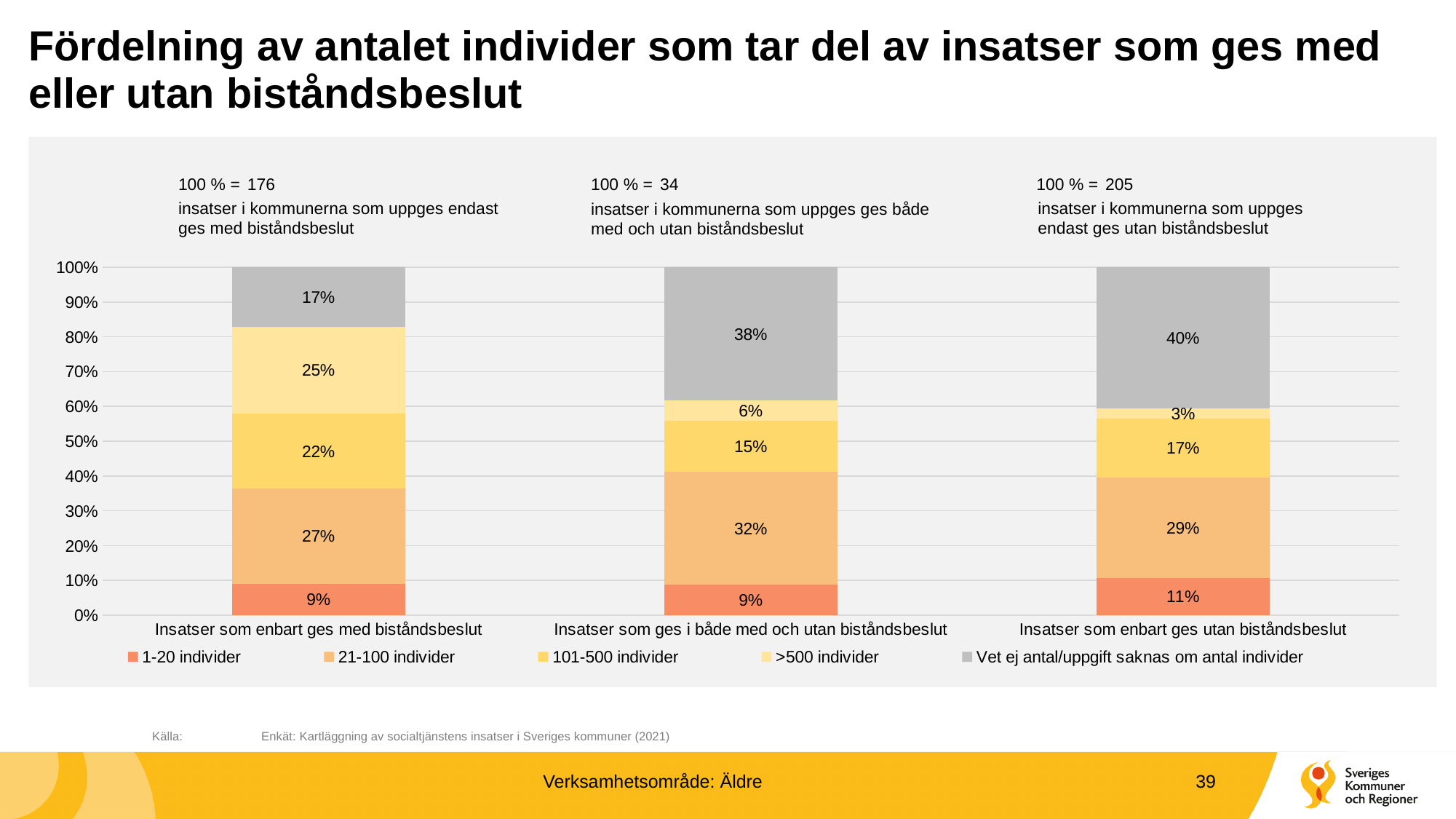
Which category has the smallest share for >500 individer? Insatser som enbart ges utan biståndsbeslut What kind of chart is shown on the slide? Stacked bar chart What is the difference in the 101-500 individer share between 'Insatser som enbart ges med biståndsbeslut' and 'Insatser som enbart ges utan biståndsbeslut'? 5 percentage points How many series does the legend list? 5 What percentage is shown for >500 individer in the bar for 'Insatser som enbart ges med biståndsbeslut'? 25% What percentage is shown for 'Vet ej antal/uppgift saknas om antal individer' in the bar for 'Insatser som enbart ges utan biståndsbeslut'? 40% How many categories (bars) are shown on the x axis? 3 Which category has the largest share for 'Vet ej antal/uppgift saknas om antal individer'? Insatser som enbart ges utan biståndsbeslut According to the text above the chart, how many insatser does 100 % correspond to for the group given both with and without biståndsbeslut? 34 Which has the larger share for 1-20 individer: 'Insatser som enbart ges med biståndsbeslut' or 'Insatser som enbart ges utan biståndsbeslut'? Insatser som enbart ges utan biståndsbeslut What percentage is shown for 21-100 individer in the bar for 'Insatser som ges i både med och utan biståndsbeslut'? 32% According to the text above the chart, how many insatser does 100 % correspond to for the group that is only given with biståndsbeslut? 176